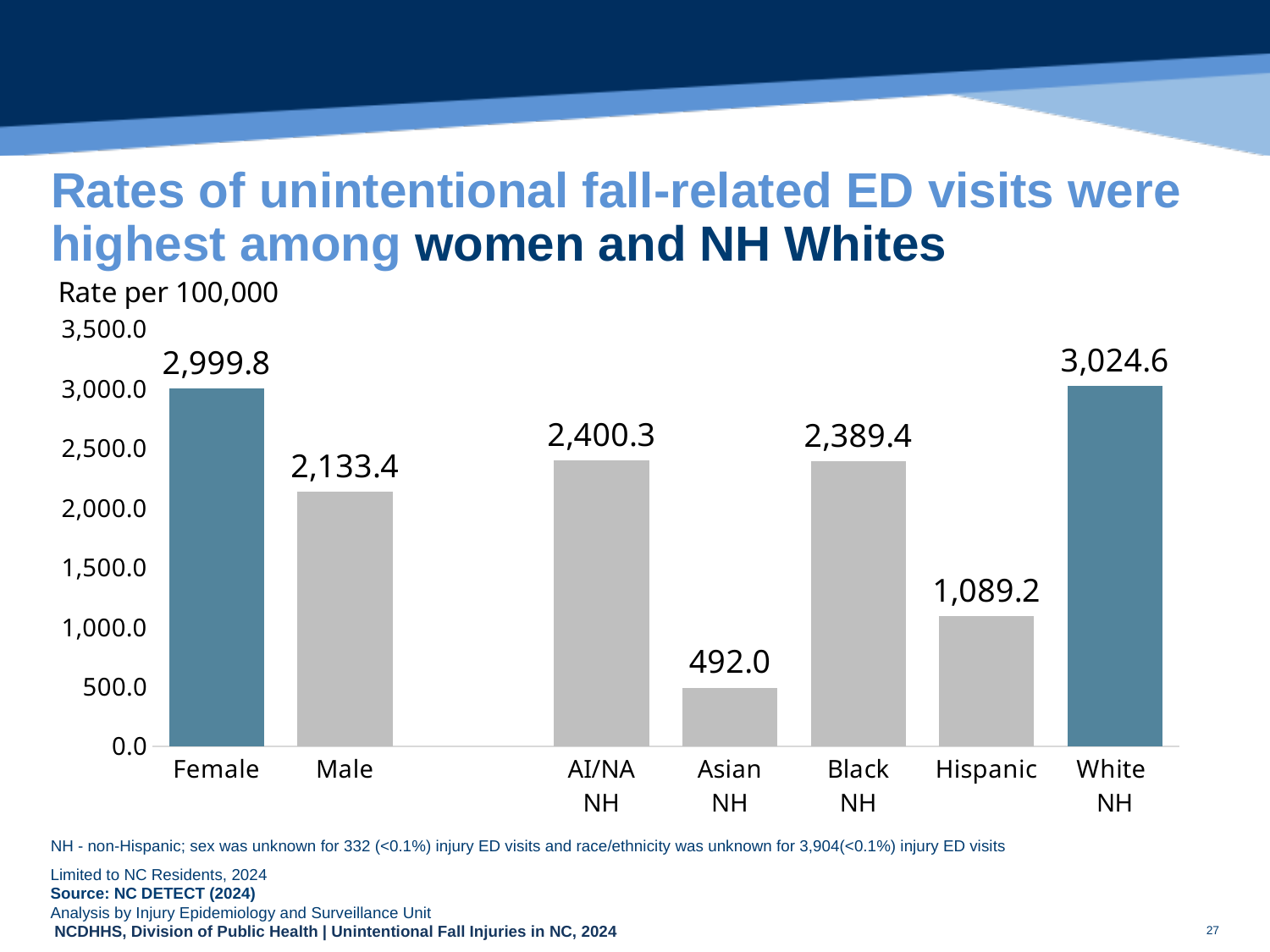
What is the rate per 100,000 for Asian NH? 492.0 Which category has the highest rate on the chart? White NH What is the rate per 100,000 of unintentional fall-related ED visits for Female? 2,999.8 Which category has the lowest rate on the chart? Asian NH How many categories are shown on the chart? 7 Is the value for Male greater or less than 2,000.0? greater What is the rate per 100,000 for Hispanic? 1,089.2 Which has a higher rate, AI/NA NH or Hispanic? AI/NA NH What is the difference between the Female and Male rates? 866.4 What is the unit label shown above the y axis of the chart? Rate per 100,000 What is the difference between the White NH and Hispanic rates? 1,935.4 What kind of chart is shown on the slide? Bar chart